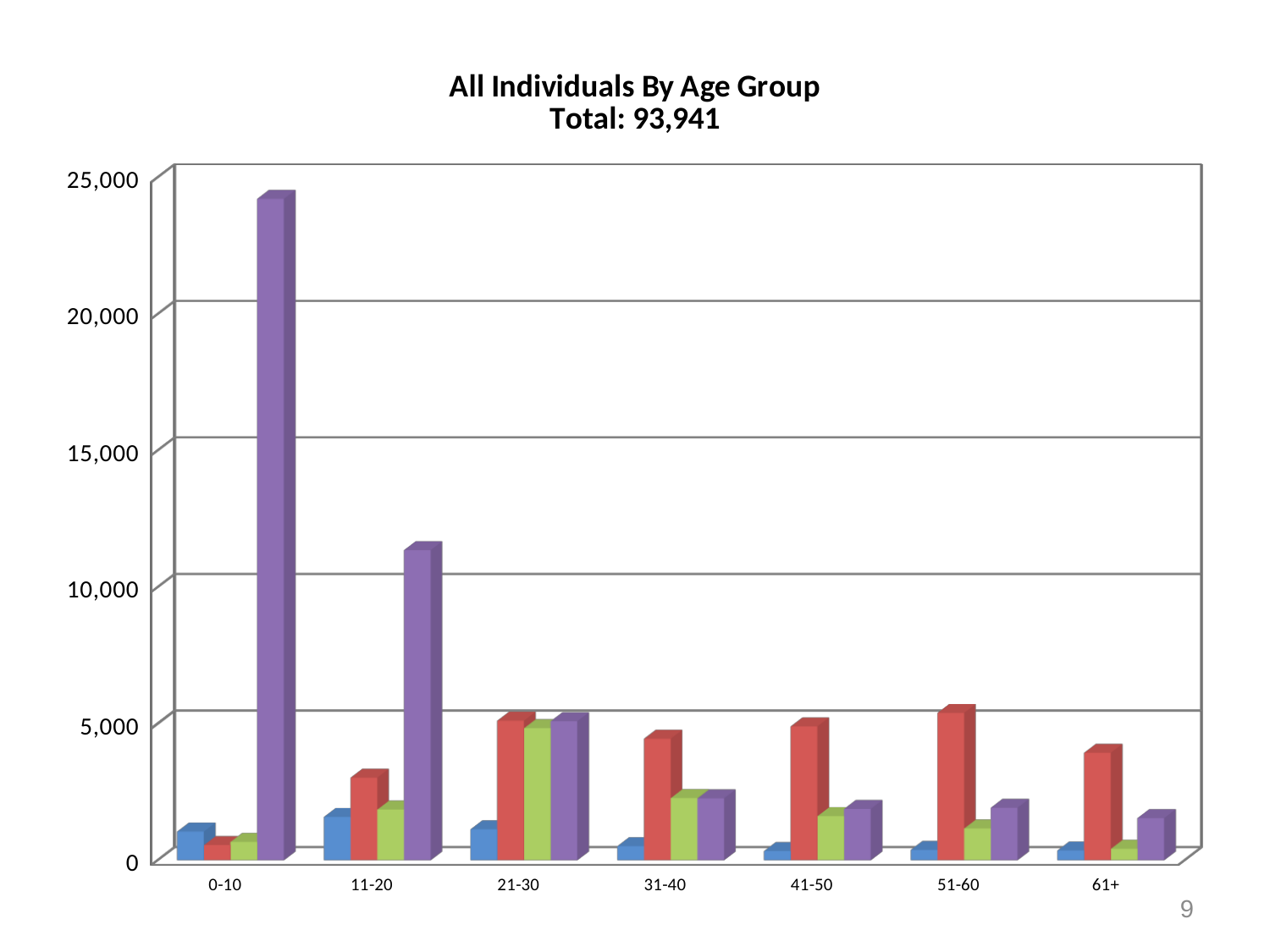
How many age group categories are shown on the x axis? 7 Which age group has the tallest purple bar? 0-10 Do the purple bars rise or fall moving from the 0-10 age group to the 61+ age group? fall What kind of chart is shown on the slide? Bar chart What total is stated in the chart title? 93,941 Is the value of the blue bar for the 0-10 age group greater or less than 5,000? less Is the value of the purple bar for the 11-20 age group greater or less than 10,000? greater Which is larger, the purple bar for 0-10 or the purple bar for 11-20? 0-10 Which age group has the tallest green bar? 21-30 What is the title of the chart? All Individuals By Age Group Total: 93,941 Is the value of the purple bar for the 0-10 age group greater or less than 20,000? greater